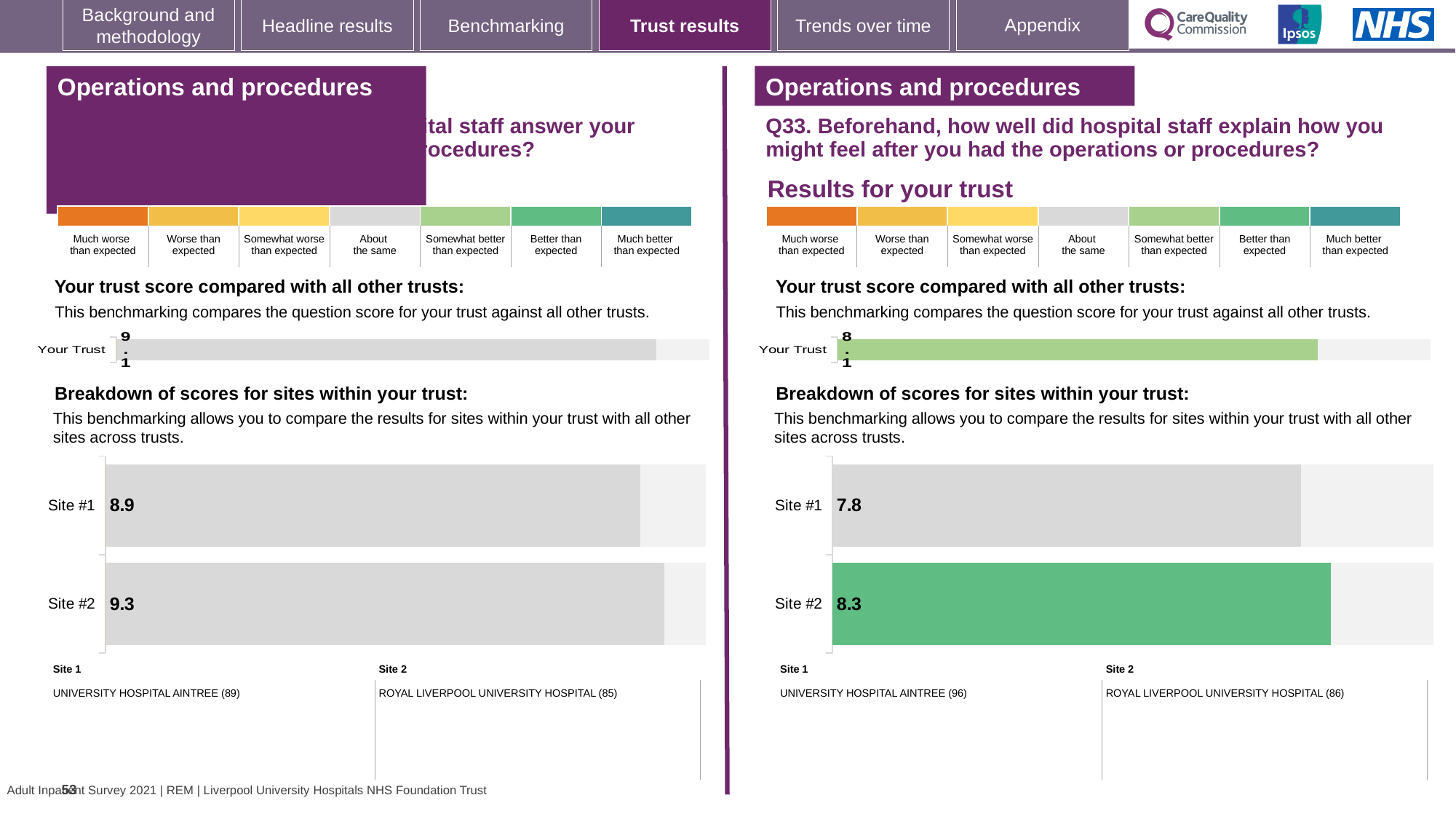
In the Q33 'Breakdown of scores for sites within your trust' chart on the right half of the slide, what is the score for Site #2? 8.3 What type of chart is used for the 'Breakdown of scores for sites within your trust' on the left half of the slide? Bar chart In the Q33 'Breakdown of scores for sites within your trust' chart on the right half of the slide, what is the score for Site #1? 7.8 In the Q33 'Breakdown of scores for sites within your trust' chart on the right half of the slide, which site has the lower score? Site #1 In the 'Your trust score compared with all other trusts' chart on the left half of the slide, what is the score for Your Trust? 9.1 How many sites are shown in the Q33 'Breakdown of scores for sites within your trust' chart on the right half of the slide? 2 In the 'Breakdown of scores for sites within your trust' chart on the left half of the slide, what is the score for Site #1? 8.9 In the Q33 'Your trust score compared with all other trusts' chart on the right half of the slide, what is the score for Your Trust? 8.1 In the Q33 'Breakdown of scores for sites within your trust' chart on the right half of the slide, what is the difference between the Site #2 and Site #1 scores? 0.5 In the 'Breakdown of scores for sites within your trust' chart on the left half of the slide, which site has the higher score? Site #2 In the 'Breakdown of scores for sites within your trust' chart on the left half of the slide, what is the difference between the Site #2 and Site #1 scores? 0.4 In the 'Breakdown of scores for sites within your trust' chart on the left half of the slide, what is the score for Site #2? 9.3